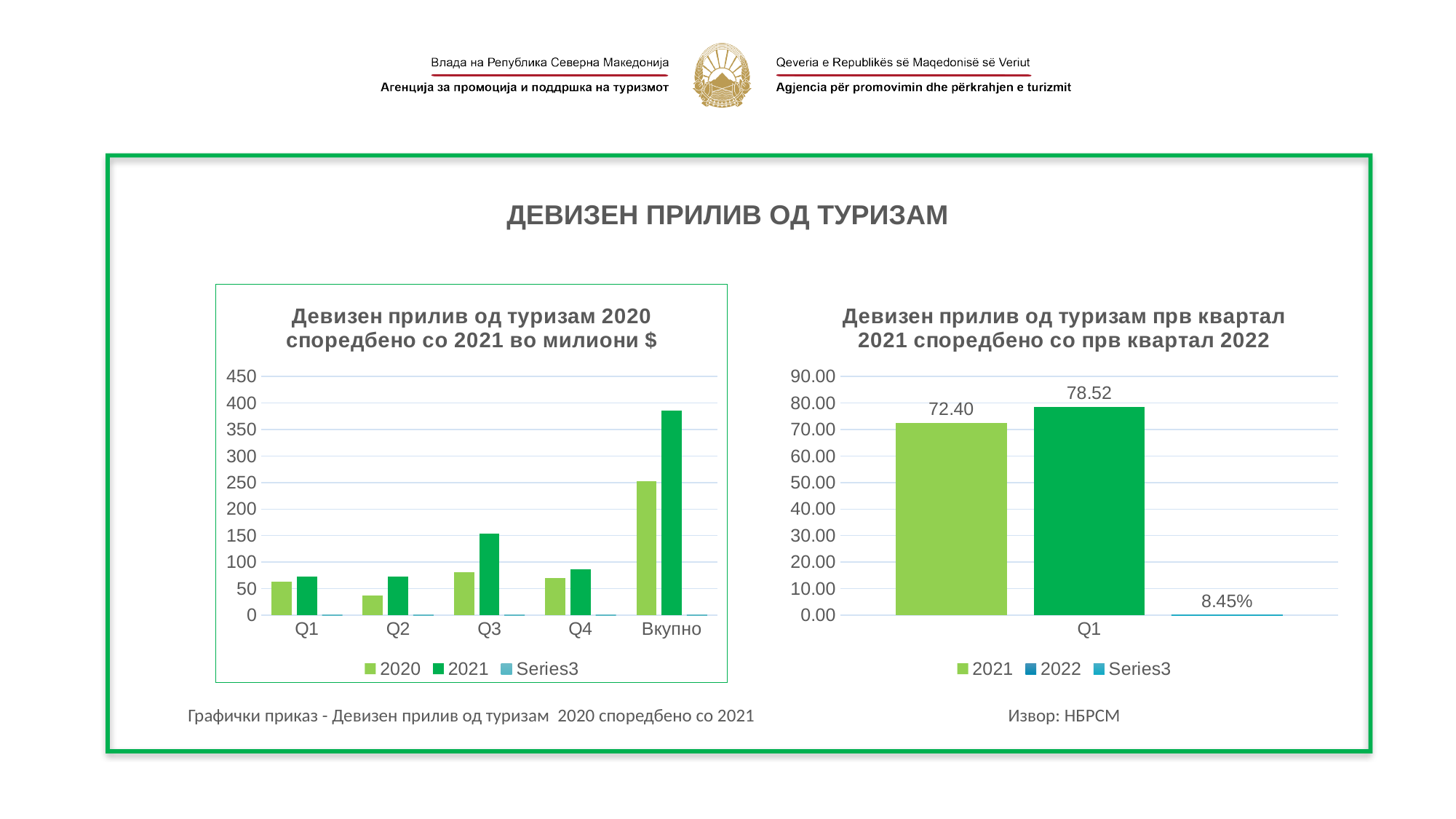
In the chart 'Девизен прилив од туризам прв квартал 2021 споредбено со прв квартал 2022', what is the value for 2021 in Q1? 72.40 In the left-hand chart, which quarter (Q1–Q4) has the lowest 2020 value? Q2 What kind of chart is 'Девизен прилив од туризам 2020 споредбено со 2021 во милиони $'? bar chart In the right-hand chart, which is larger for Q1: the 2021 value or the 2022 value? 2022 In the right-hand chart, what is the difference between the 2022 and 2021 values for Q1? 6.12 In the left-hand chart, which quarter (Q1–Q4) has the highest 2021 value? Q3 How many categories are shown on the x axis of the left-hand chart? 5 In the chart 'Девизен прилив од туризам прв квартал 2021 споредбено со прв квартал 2022', what is the value for 2022 in Q1? 78.52 In the right-hand chart, what is the label shown on the Series3 bar? 8.45% In the left-hand chart, is the 2020 value for Q2 greater or less than 50? less How many series does the legend of the right-hand chart list? 3 In the left-hand chart, is the 2021 value for Вкупно greater or less than 350? greater